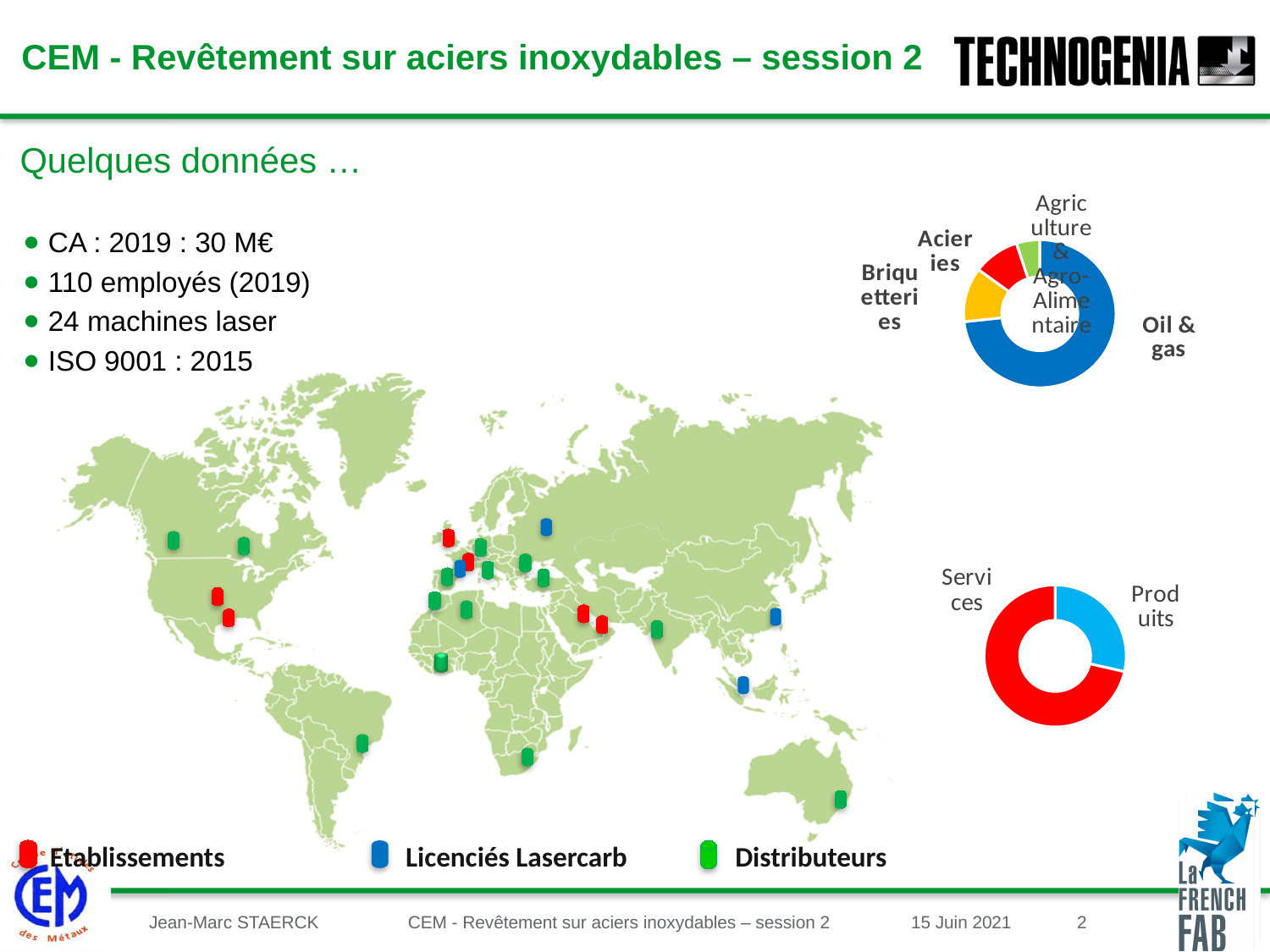
In the upper doughnut chart, which has the larger share, Acieries or Agriculture & Agro-Alimentaire? Acieries In the lower doughnut chart, which category is the smaller one? Produits In the lower doughnut chart, how many categories are shown? 2 In the upper doughnut chart, how many categories are shown? 4 In the lower doughnut chart, what colour is the Services segment? Red In the upper doughnut chart, which category has the smallest share? Agriculture & Agro-Alimentaire In the lower doughnut chart, which category has the larger share, Services or Produits? Services What kind of chart is the upper chart on the right side of the slide? Doughnut chart In the upper doughnut chart, what colour is the Oil & gas segment? Blue In the upper doughnut chart, which has the larger share, Oil & gas or Briquetteries? Oil & gas In the upper doughnut chart, which category has the largest share? Oil & gas What kind of chart is the lower chart on the right side of the slide? Doughnut chart